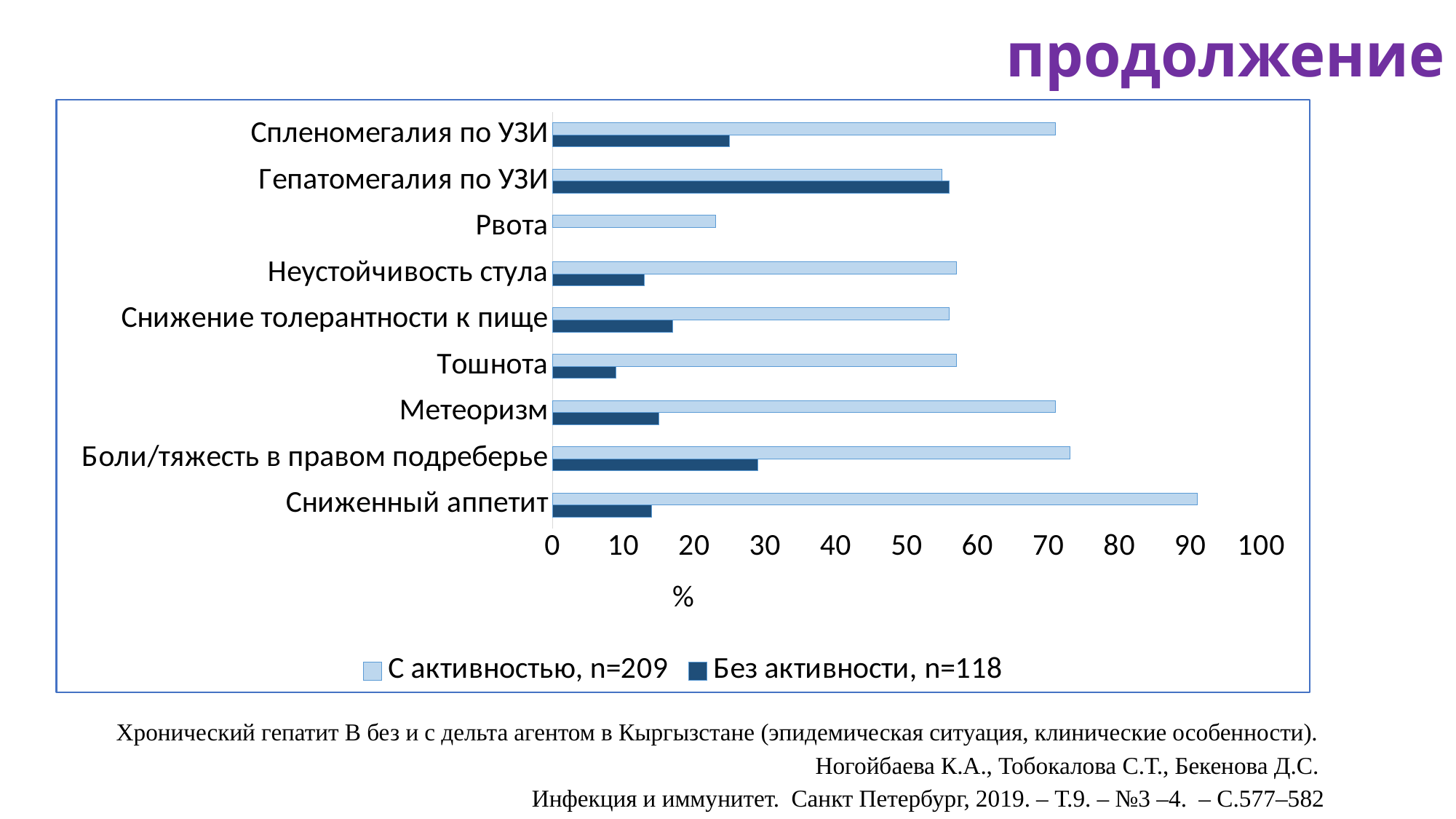
Which category has the highest value for the series 'С активностью, n=209'? Сниженный аппетит How many series does the legend list? 2 Is the value for 'Сниженный аппетит' in the series 'С активностью, n=209' greater or less than 80? greater For 'Спленомегалия по УЗИ', which series has the larger value: 'С активностью, n=209' or 'Без активности, n=118'? С активностью, n=209 What kind of chart is shown on the slide? bar chart Is the value for 'Спленомегалия по УЗИ' in the series 'Без активности, n=118' greater or less than 30? less Is the value for 'Тошнота' in the series 'Без активности, n=118' greater or less than 20? less Which category has the highest value for the series 'Без активности, n=118'? Гепатомегалия по УЗИ How many categories (symptoms) are plotted on the chart? 9 Which category has the lowest value for the series 'С активностью, n=209'? Рвота What unit is shown on the horizontal axis of the chart? %